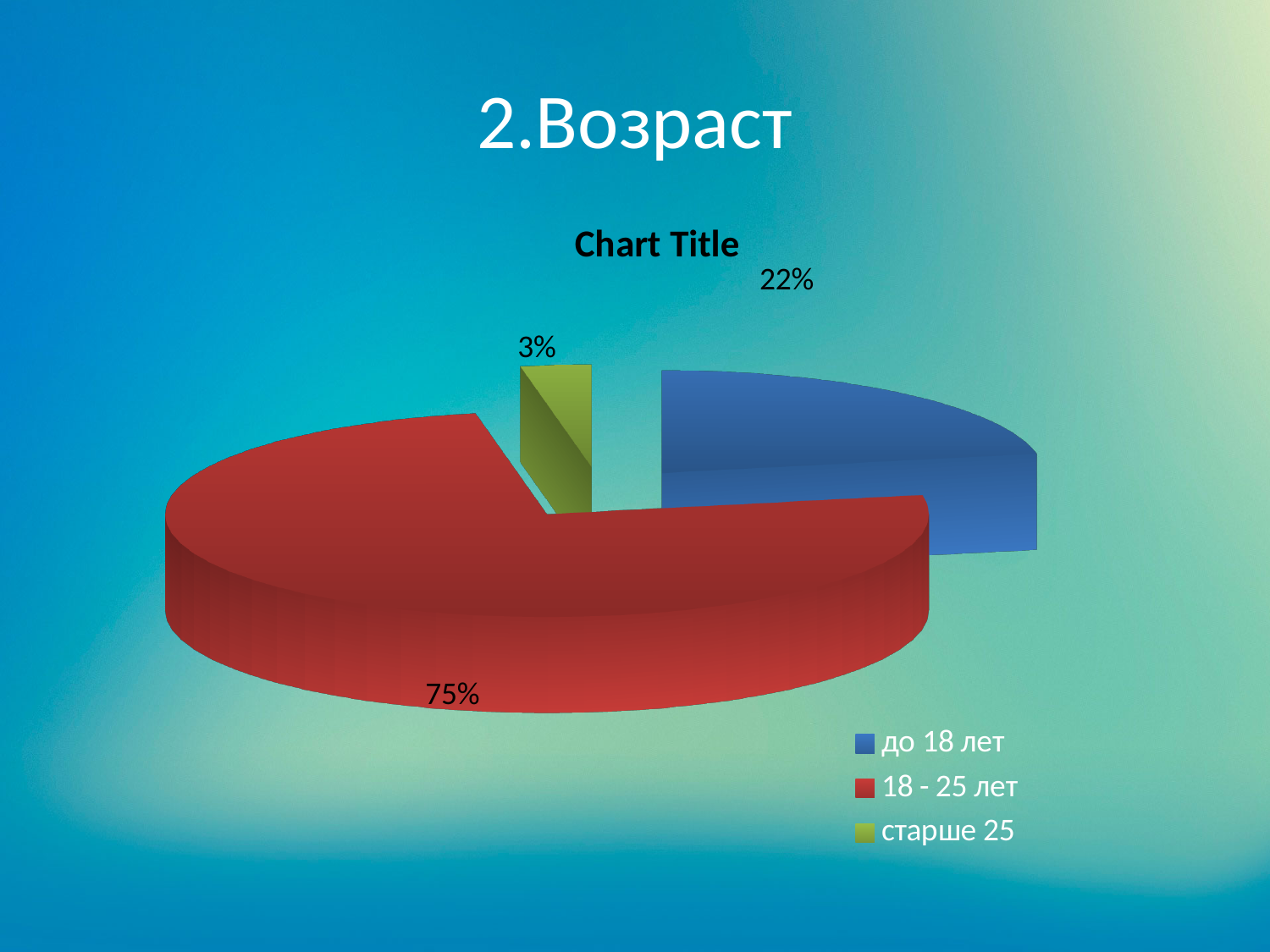
What share of the pie does the 'старше 25' slice represent? 3% How many categories does the pie chart have? 3 Which category has the smallest slice of the pie? старше 25 What is the difference in percentage points between the '18 - 25 лет' slice and the 'до 18 лет' slice? 53% What kind of chart is shown on the slide? pie chart Which is larger, the 'до 18 лет' slice or the 'старше 25' slice? до 18 лет What share of the pie does the 'до 18 лет' slice represent? 22% What is the difference in percentage points between the 'до 18 лет' slice and the 'старше 25' slice? 19% What is the title shown above the pie chart? Chart Title Which category has the largest slice of the pie? 18 - 25 лет What share of the pie does the '18 - 25 лет' slice represent? 75% What colour is the '18 - 25 лет' slice in the pie chart? red